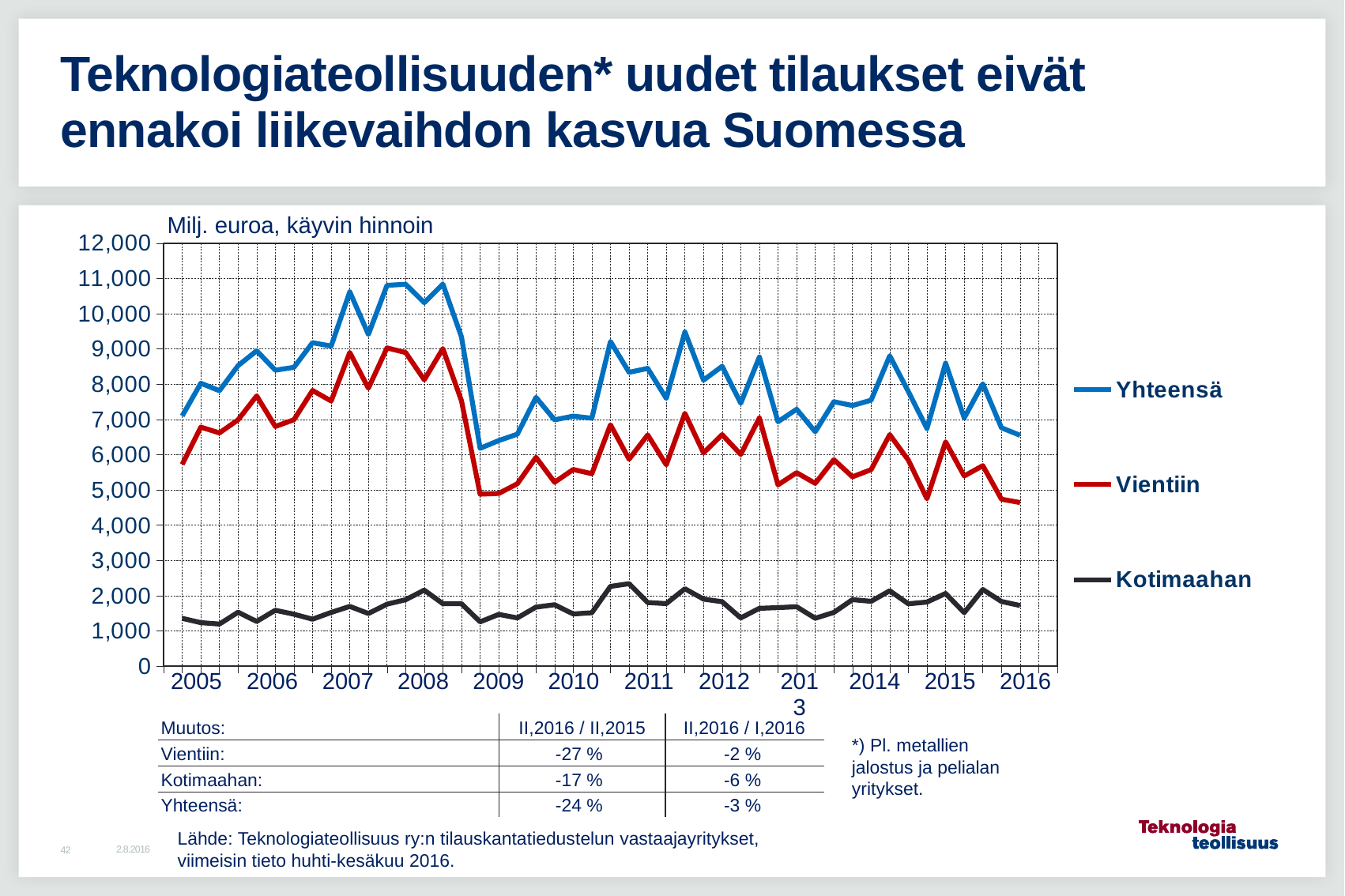
Which series has the highest values throughout the chart? Yhteensä What unit label is shown above the chart? Milj. euroa, käyvin hinnoin Which series has the lowest values throughout the chart? Kotimaahan What kind of chart is shown on the slide? line chart Is the value for Vientiin at the end of 2016 greater or less than 5,000? less Which series is shown in red in the chart? Vientiin Does the Yhteensä series rise or fall from 2005 to 2008? rise Is the peak value of Yhteensä around 2007–2008 greater or less than 10,000? greater Which is larger in 2016, Vientiin or Kotimaahan? Vientiin How many years are labelled on the x axis? 12 Is the value for Kotimaahan ever greater or less than 3,000? less How many series does the legend list? 3